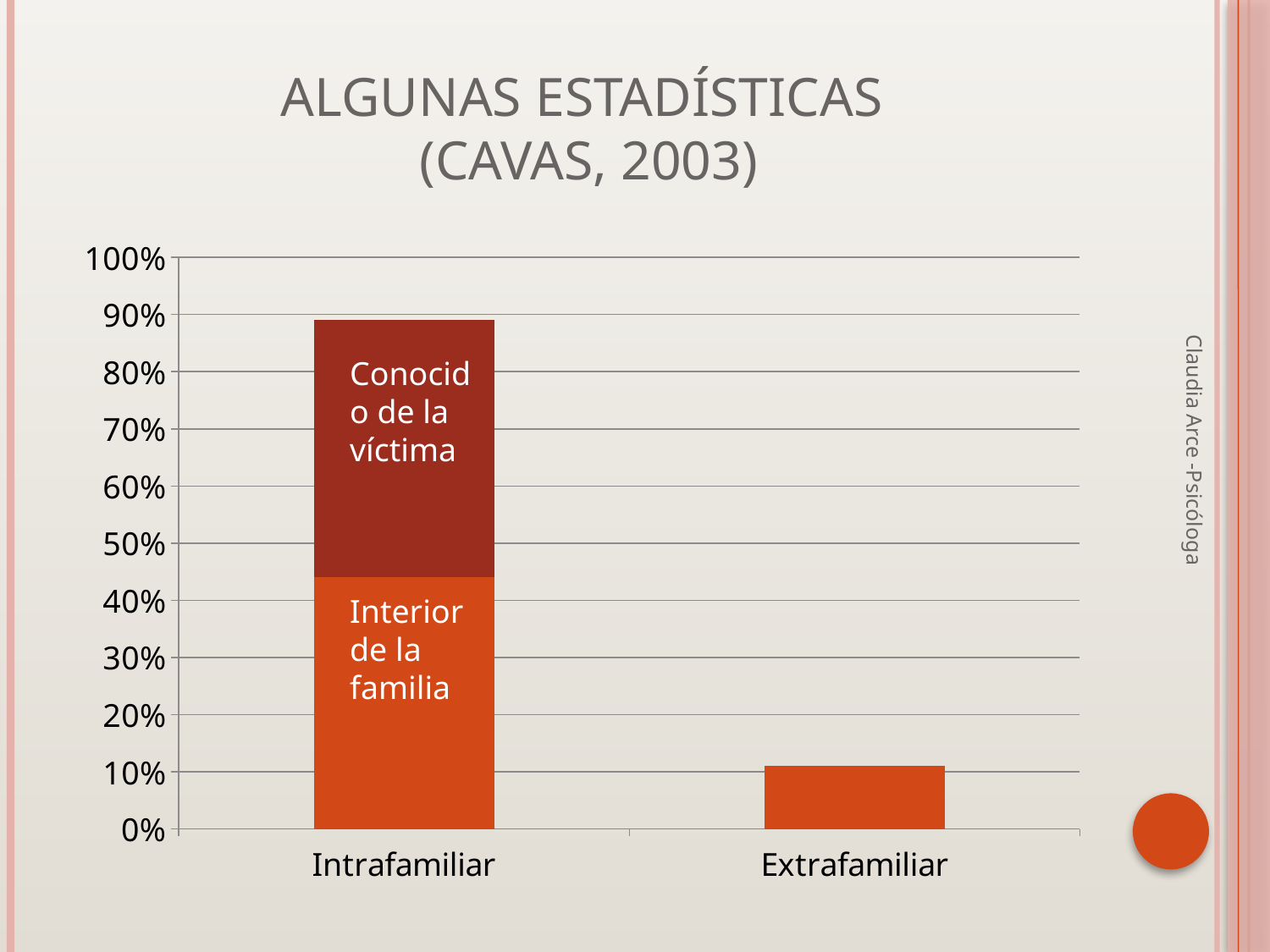
What is the title of the slide containing the chart? ALGUNAS ESTADÍSTICAS (CAVAS, 2003) What kind of chart is shown on the slide? bar chart Which category has the tallest bar in the chart? Intrafamiliar Do the bar values rise or fall from Intrafamiliar to Extrafamiliar? fall What are the two segments labelled inside the Intrafamiliar bar? Conocido de la víctima and Interior de la familia How many categories are shown on the x axis of the chart? 2 Is the total value for Intrafamiliar greater or less than 80%? greater Which bar is taller, Intrafamiliar or Extrafamiliar? Intrafamiliar Which category has the shortest bar in the chart? Extrafamiliar Is the value for Extrafamiliar greater or less than 20%? less Is the 'Interior de la familia' segment of the Intrafamiliar bar greater or less than 50%? less